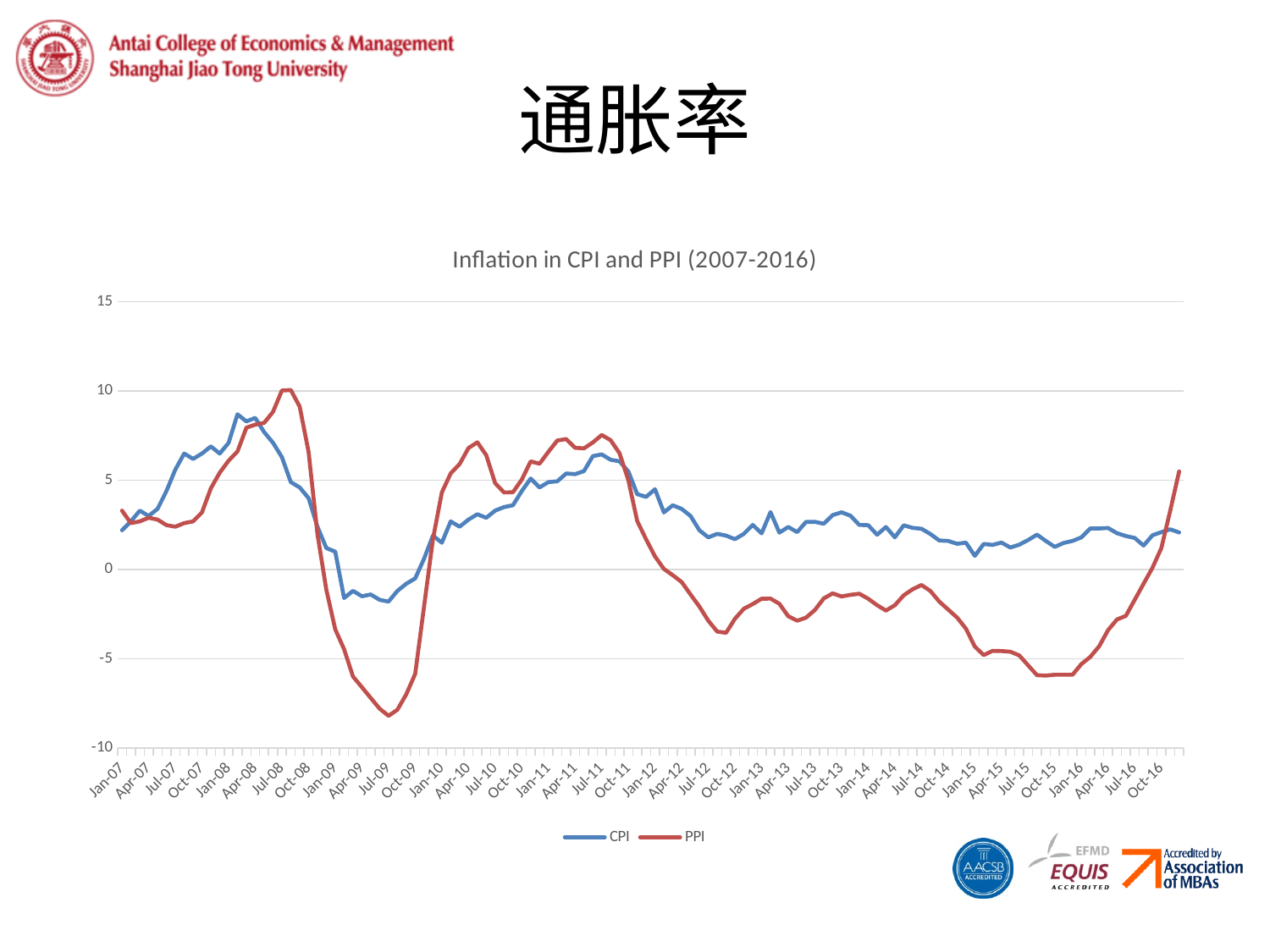
In which year does the PPI line reach its lowest value? 2009 How many series does the legend list? 2 Which colour is used for the PPI line? red At Jul-08, which series has the higher value, CPI or PPI? PPI What is the title of the chart? Inflation in CPI and PPI (2007-2016) Does the PPI line rise or fall between Jan-16 and Oct-16? rise What kind of chart is shown on the slide? line chart Is the PPI value at Oct-15 greater or less than -5? less Is the PPI value at Jul-09 greater or less than -5? less Is the CPI value at Apr-08 greater or less than 5? greater At Jul-09, which series has the higher value, CPI or PPI? CPI